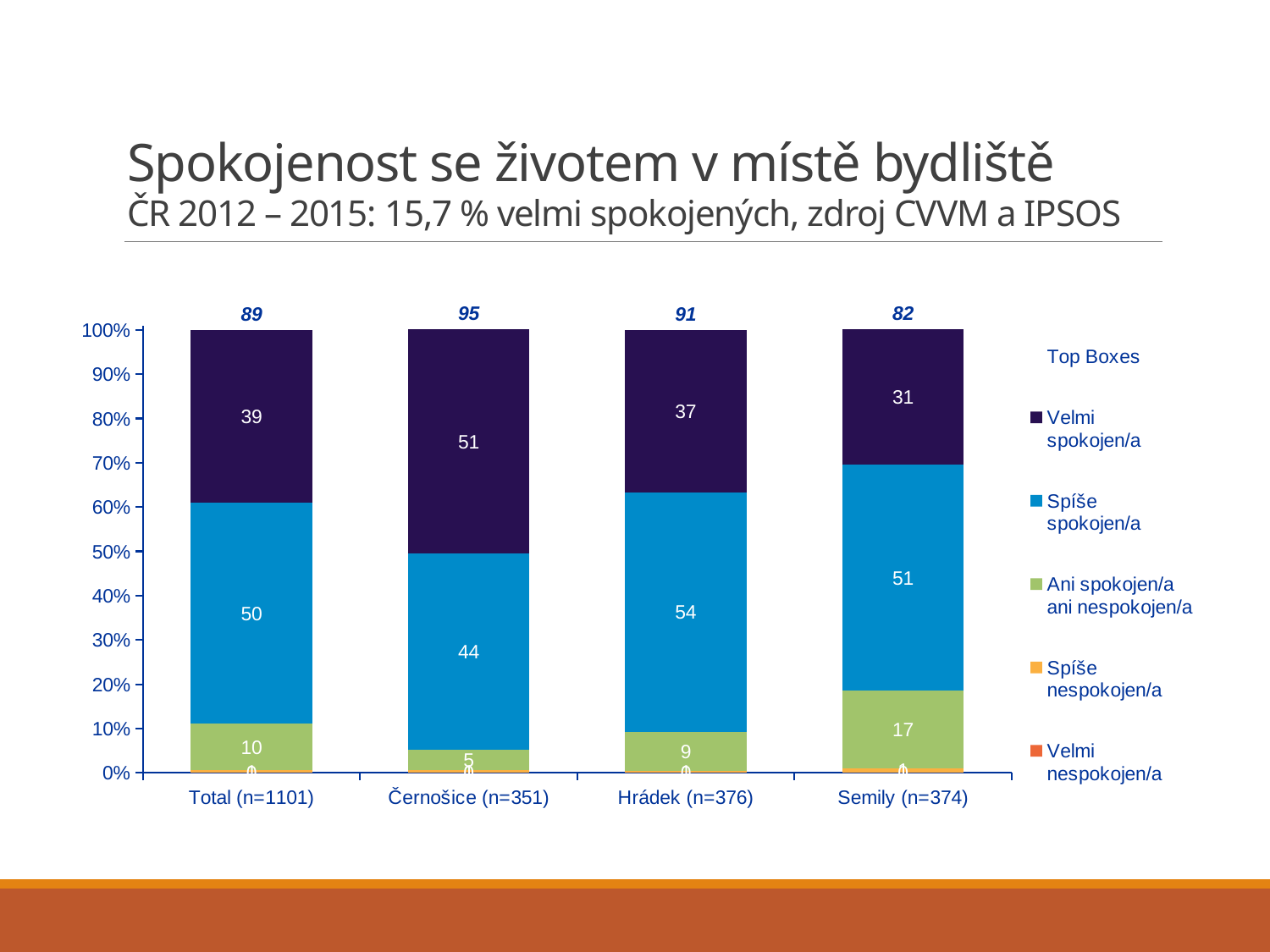
How many series does the legend list? 6 What is the value of Velmi spokojen/a for Černošice (n=351)? 51 Which has a larger Spíše spokojen/a value, Hrádek (n=376) or Černošice (n=351)? Hrádek (n=376) Which category has the highest Top Boxes value? Černošice (n=351) How many categories are shown on the x axis? 4 What is the Top Boxes value shown above the Semily (n=374) bar? 82 Which category has the highest value for Velmi spokojen/a? Černošice (n=351) Which category has the lowest value for Velmi spokojen/a? Semily (n=374) What is the value of Spíše spokojen/a for Hrádek (n=376)? 54 What is the difference between the Velmi spokojen/a values for Černošice (n=351) and Semily (n=374)? 20 What is the value of Ani spokojen/a ani nespokojen/a for Semily (n=374)? 17 What kind of chart is shown on the slide? Stacked bar chart